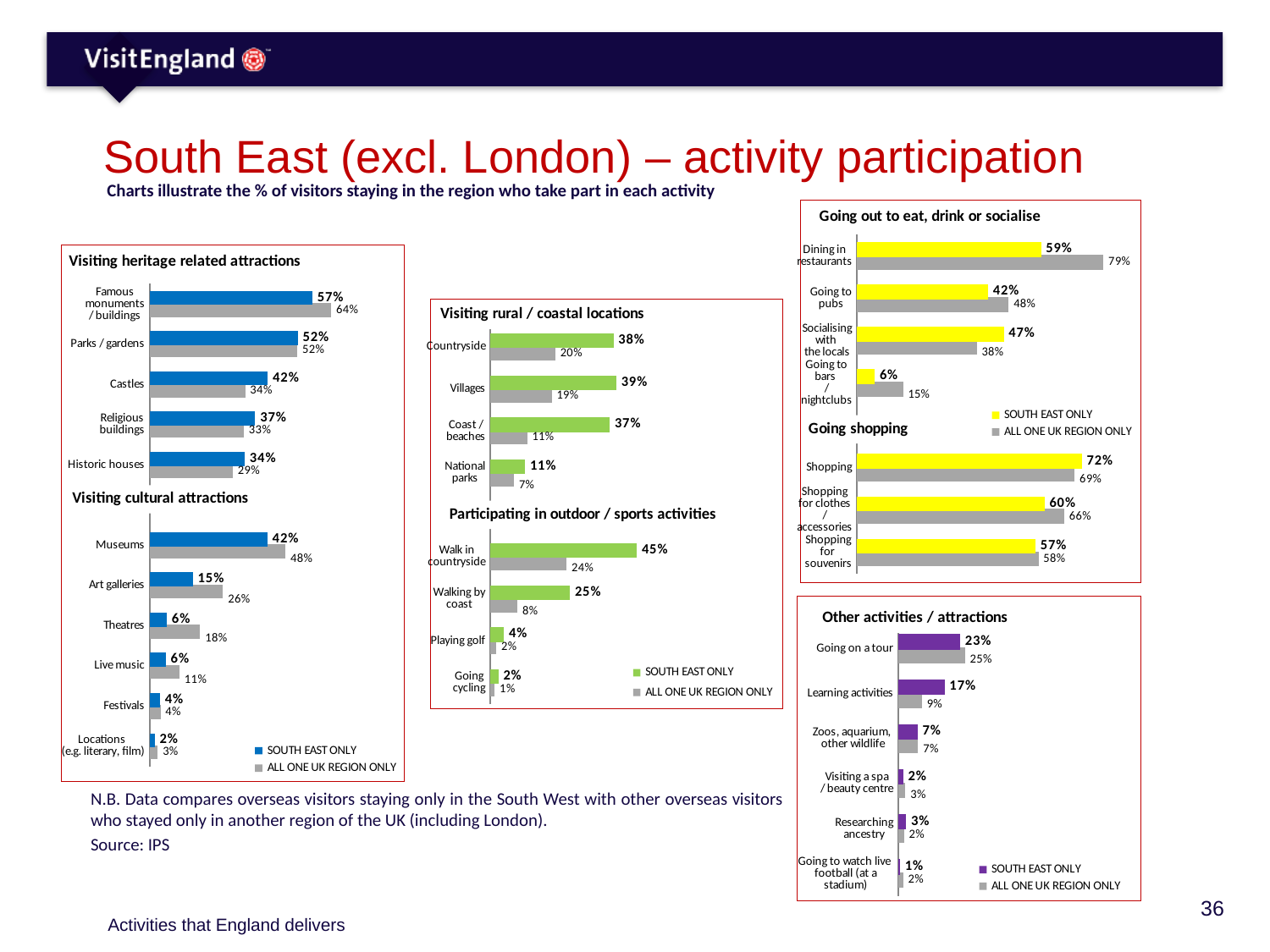
How many series does the legend of the 'Other activities / attractions' chart list? 2 In the 'Going shopping' chart, what is the SOUTH EAST ONLY value for Shopping? 72% In the 'Visiting cultural attractions' chart, which category has the highest SOUTH EAST ONLY value? Museums In the 'Visiting heritage related attractions' chart, what is the SOUTH EAST ONLY value for Castles? 42% In the 'Participating in outdoor / sports activities' chart, how many categories are shown? 4 In the 'Visiting rural / coastal locations' chart, what is the SOUTH EAST ONLY value for Villages? 39% In the 'Going out to eat, drink or socialise' chart, which is larger for Dining in restaurants: SOUTH EAST ONLY or ALL ONE UK REGION ONLY? ALL ONE UK REGION ONLY In the 'Visiting rural / coastal locations' chart, which category has the lowest SOUTH EAST ONLY value? National parks In the 'Participating in outdoor / sports activities' chart, what is the ALL ONE UK REGION ONLY value for Walk in countryside? 24% In the 'Other activities / attractions' chart, what is the SOUTH EAST ONLY value for Learning activities? 17% In the 'Visiting heritage related attractions' chart, what is the ALL ONE UK REGION ONLY value for Famous monuments / buildings? 64% In the 'Visiting cultural attractions' chart, what is the difference between the ALL ONE UK REGION ONLY and SOUTH EAST ONLY values for Art galleries? 11%